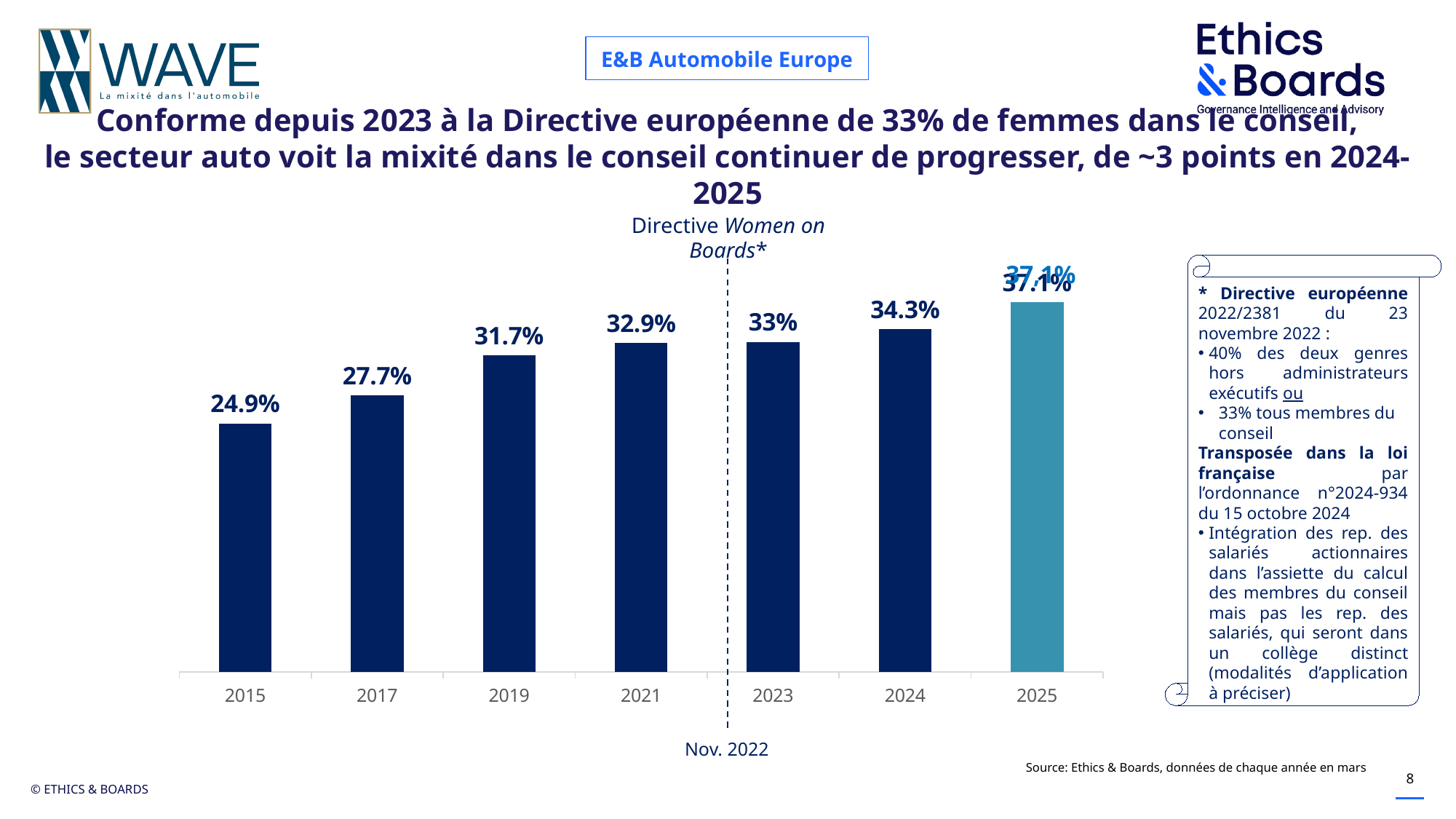
What is the value shown for 2023? 33% What is the value shown for 2025? 37.1% How many years are shown on the x axis? 7 What kind of chart is shown on the slide? Bar chart Which year has the lowest value? 2015 Which year has the highest value? 2025 What is the value shown for 2019? 31.7% What is the value shown for 2015? 24.9% What is the difference between the values for 2025 and 2024? 2.8 points What is the difference between the values for 2017 and 2015? 2.8 points Do the values rise or fall from 2015 to 2025? Rise Which is larger, the value for 2021 or the value for 2023? 2023